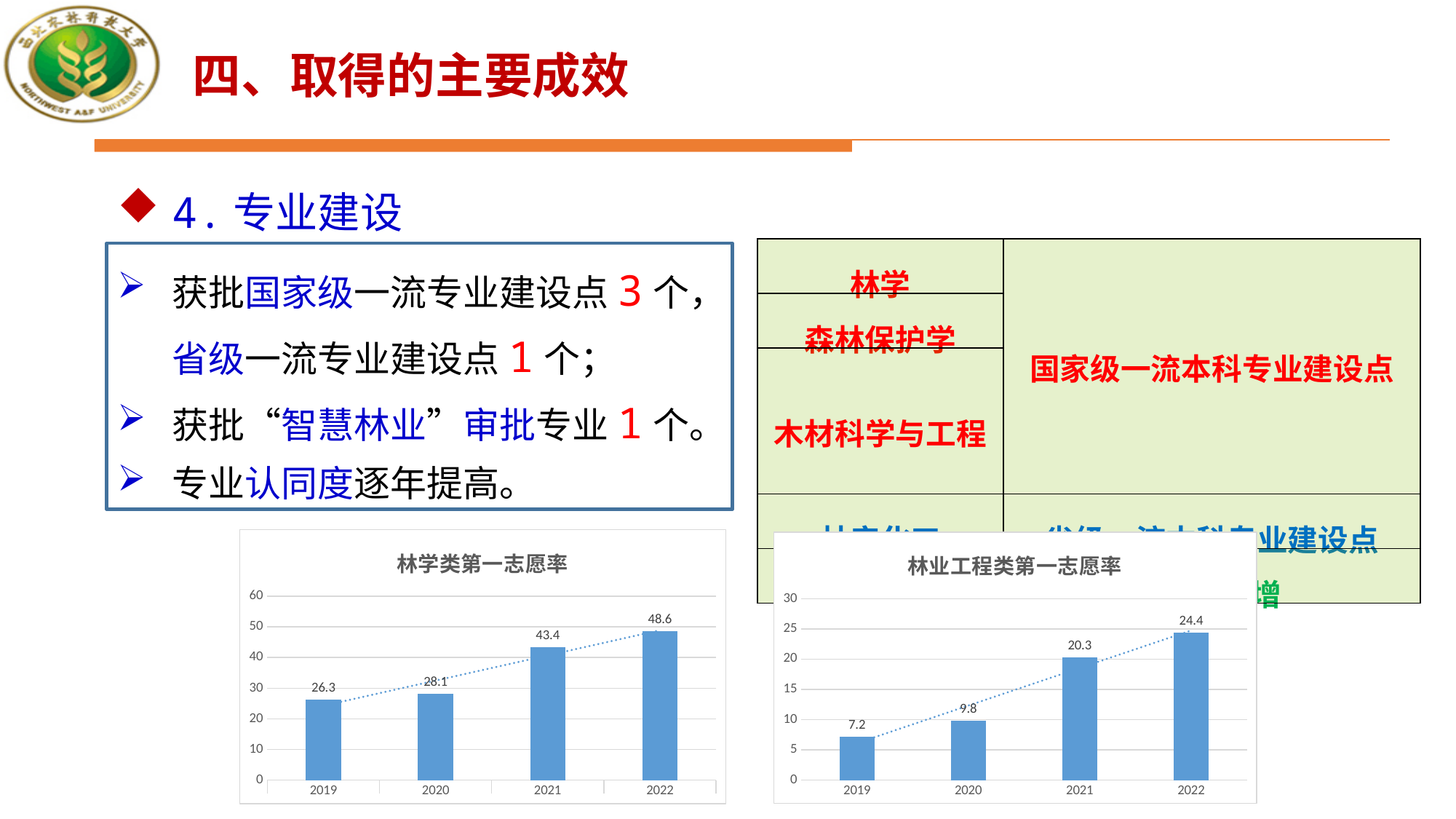
In the 林业工程类第一志愿率 chart, is the value for 2022 greater or less than 20? greater In the 林学类第一志愿率 chart, how many years are shown on the x axis? 4 In the 林业工程类第一志愿率 chart, what is the value for 2021? 20.3 In the 林业工程类第一志愿率 chart, which year has the lowest value? 2019 In the 林学类第一志愿率 chart, what is the difference between the 2021 and 2020 values? 15.3 What kind of chart is the 林业工程类第一志愿率 chart? bar chart In the 林业工程类第一志愿率 chart, what is the value for 2020? 9.8 In the 林学类第一志愿率 chart, what is the value for 2019? 26.3 In the 林学类第一志愿率 chart, which year has the highest value? 2022 In the 林业工程类第一志愿率 chart, what is the difference between the 2022 and 2019 values? 17.2 In the 林学类第一志愿率 chart, do the values rise or fall from 2019 to 2022? rise In the 林学类第一志愿率 chart, what is the value for 2022? 48.6